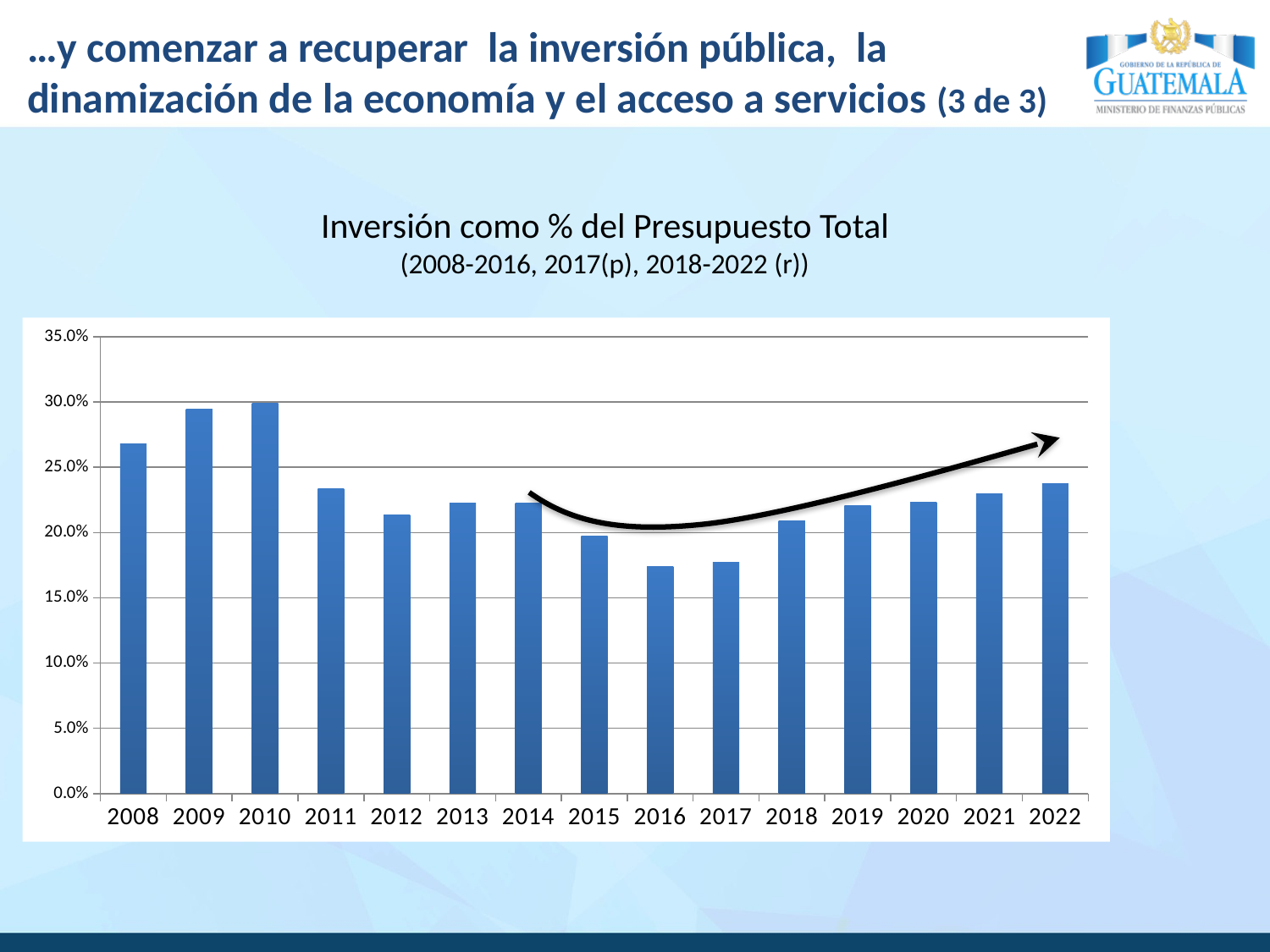
How many years are shown on the x axis of the chart? 15 Do the values rise or fall from 2010 to 2016? fall Is the value for 2016 greater or less than 20.0%? less Is the value for 2022 greater or less than 25.0%? less What kind of chart is shown on the slide? bar chart Is the value for 2008 greater or less than 25.0%? greater Which year has the larger value, 2015 or 2022? 2022 What is the title of the chart? Inversión como % del Presupuesto Total Which year has the larger value, 2008 or 2011? 2008 Do the values rise or fall from 2017 to 2022? rise